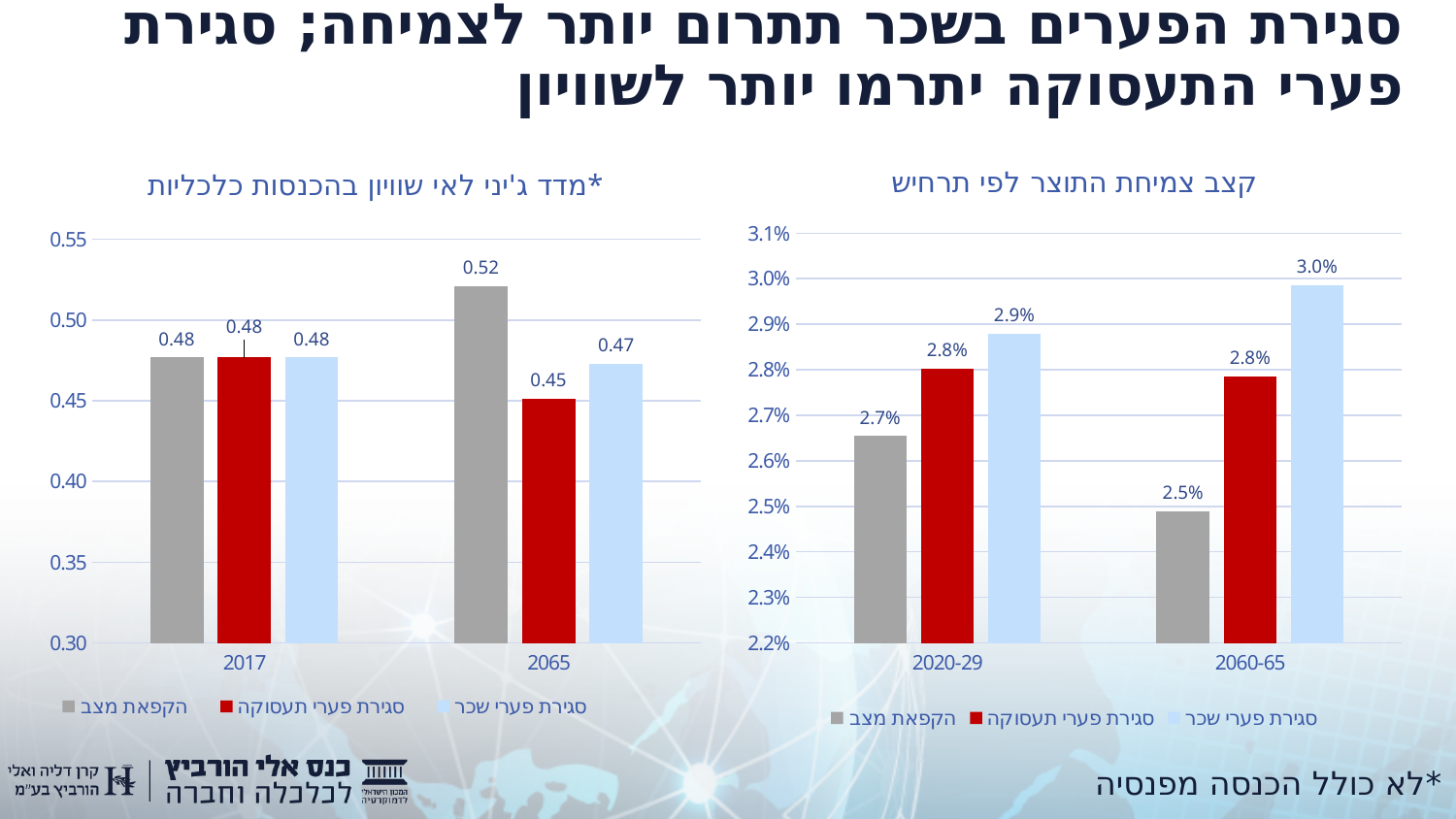
In the right-hand chart (קצב צמיחת התוצר לפי תרחיש), what is the difference between סגירת פערי שכר and הקפאת מצב in 2060-65? 0.5% In the right-hand chart (קצב צמיחת התוצר לפי תרחיש), what is the value for סגירת פערי שכר in 2060-65? 3.0% In the left-hand chart (מדד ג'יני לאי שוויון בהכנסות כלכליות), what is the value for סגירת פערי תעסוקה in 2065? 0.45 In the right-hand chart (קצב צמיחת התוצר לפי תרחיש), what is the value for הקפאת מצב in 2020-29? 2.7% In the right-hand chart (קצב צמיחת התוצר לפי תרחיש), which is larger in 2020-29: סגירת פערי שכר or הקפאת מצב? סגירת פערי שכר What kind of chart is the right-hand chart (קצב צמיחת התוצר לפי תרחיש)? Bar chart How many series does the legend of the left-hand chart (מדד ג'יני לאי שוויון בהכנסות כלכליות) list? 3 In the right-hand chart (קצב צמיחת התוצר לפי תרחיש), does the value for הקפאת מצב rise or fall from 2020-29 to 2060-65? Fall In the right-hand chart (קצב צמיחת התוצר לפי תרחיש), which series has the lowest value in 2060-65? הקפאת מצב In the left-hand chart (מדד ג'יני לאי שוויון בהכנסות כלכליות), what is the value for הקפאת מצב in 2065? 0.52 In the left-hand chart (מדד ג'יני לאי שוויון בהכנסות כלכליות), which series has the highest value in 2065? הקפאת מצב In the left-hand chart (מדד ג'יני לאי שוויון בהכנסות כלכליות), what is the difference between הקפאת מצב and סגירת פערי תעסוקה in 2065? 0.07